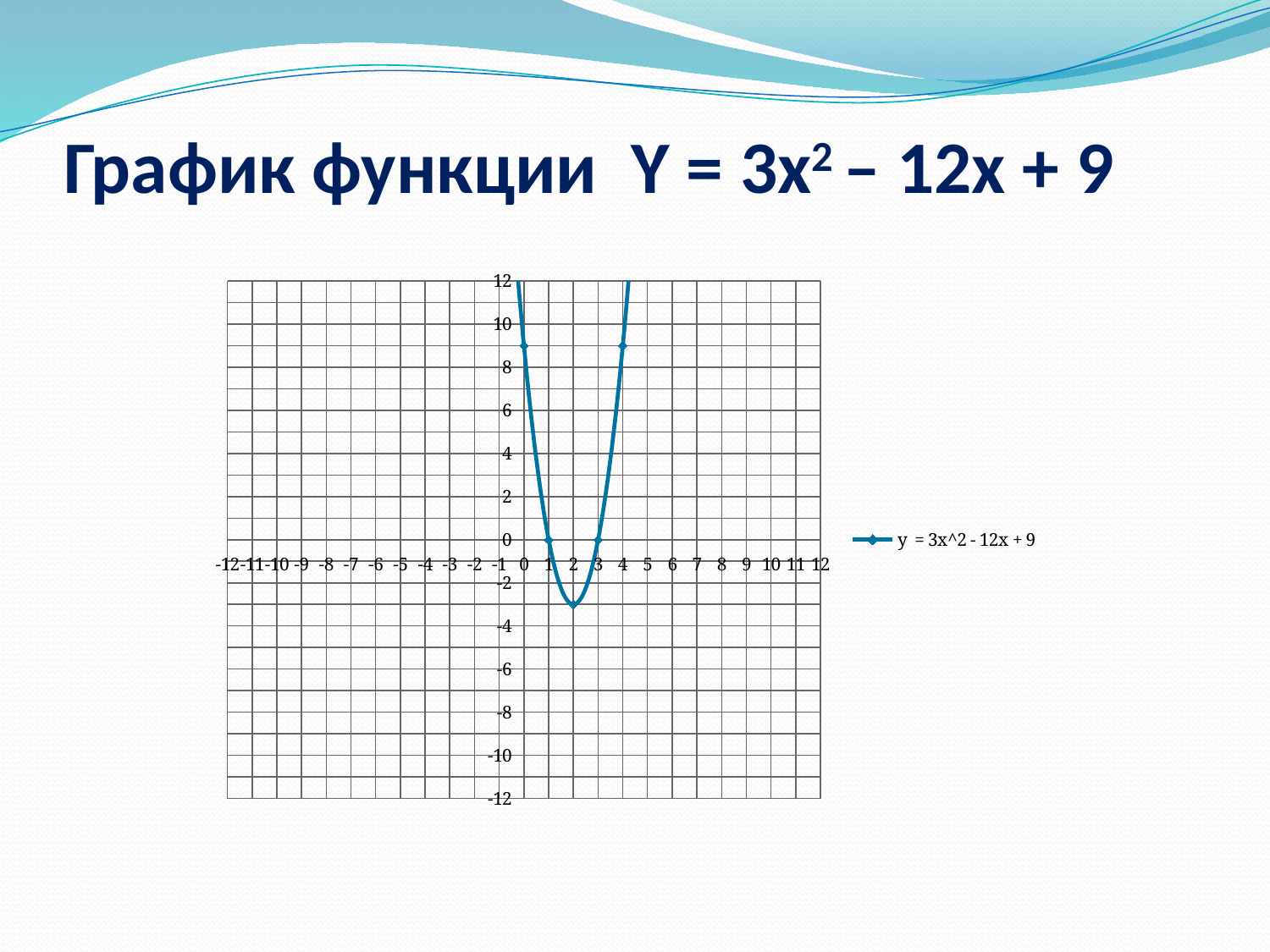
Do the y values rise or fall as x goes from 0 to 2? fall What kind of chart is shown on the slide? line chart At which x value does the curve reach its lowest point? 2 What is the highest value shown on the y axis? 12 What is the value of y at x = 1? 0 Is the value of y at x = 0 greater or less than 8? greater Is the value of y at x = 4 greater or less than 10? less What is the legend entry for the plotted series? y = 3x^2 - 12x + 9 How many series does the legend list? 1 Is the value of y at x = 2 greater or less than -2? less What is the value of y at x = 3? 0 Which is larger, the value of y at x = 0 or at x = 2? x = 0